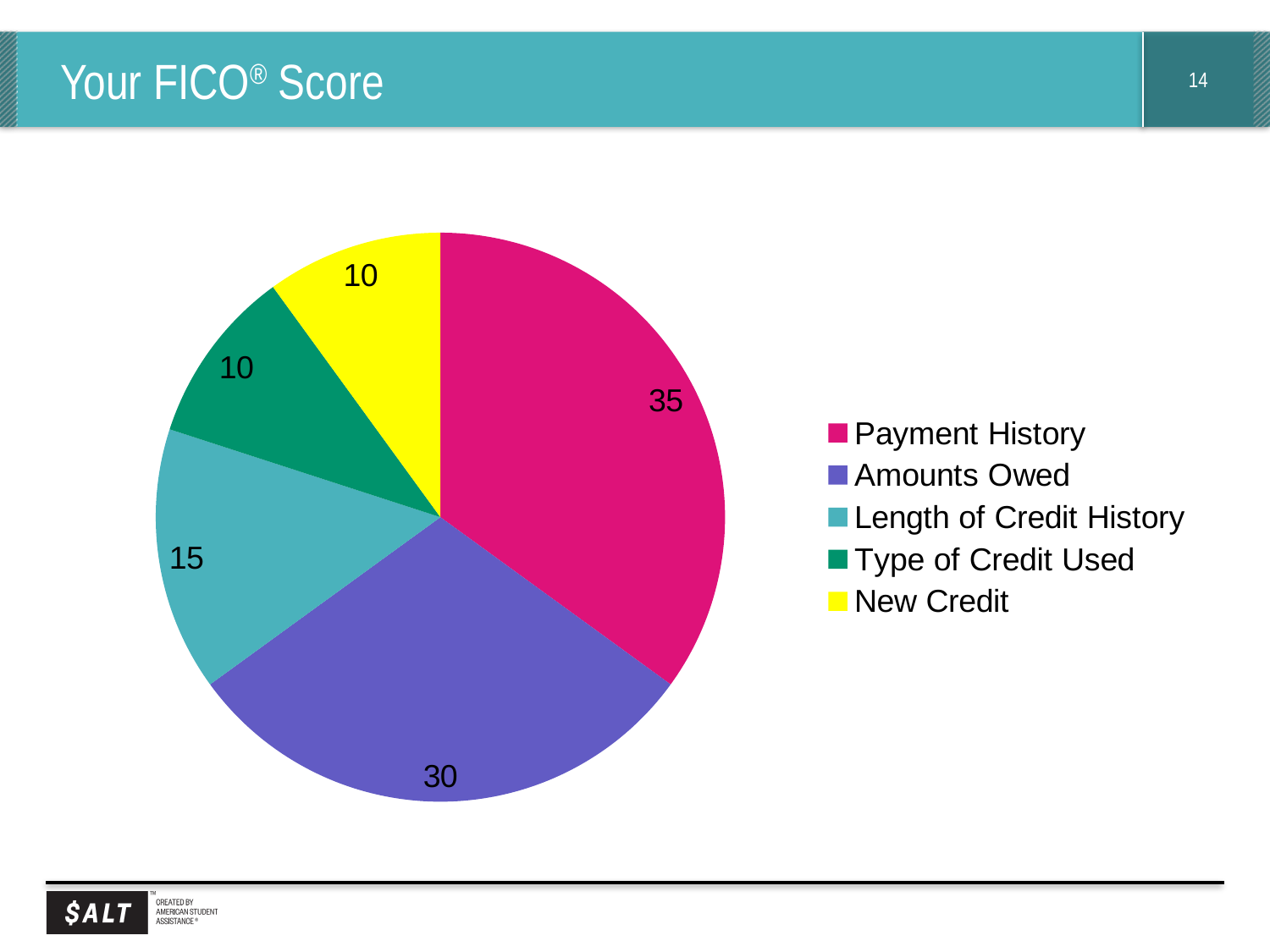
How many categories does the pie chart have? 5 What kind of chart is shown on the slide? pie chart Which is larger, Length of Credit History or Type of Credit Used? Length of Credit History What is the value for New Credit? 10 What share of the pie does Payment History represent? 35% What is the value for Payment History? 35 What is the value for Amounts Owed? 30 Which colour represents New Credit in the legend? yellow Which category has the largest slice of the pie? Payment History What is the total of all the slice values in the pie chart? 100 What is the value for Length of Credit History? 15 What is the difference between the values for Payment History and Amounts Owed? 5